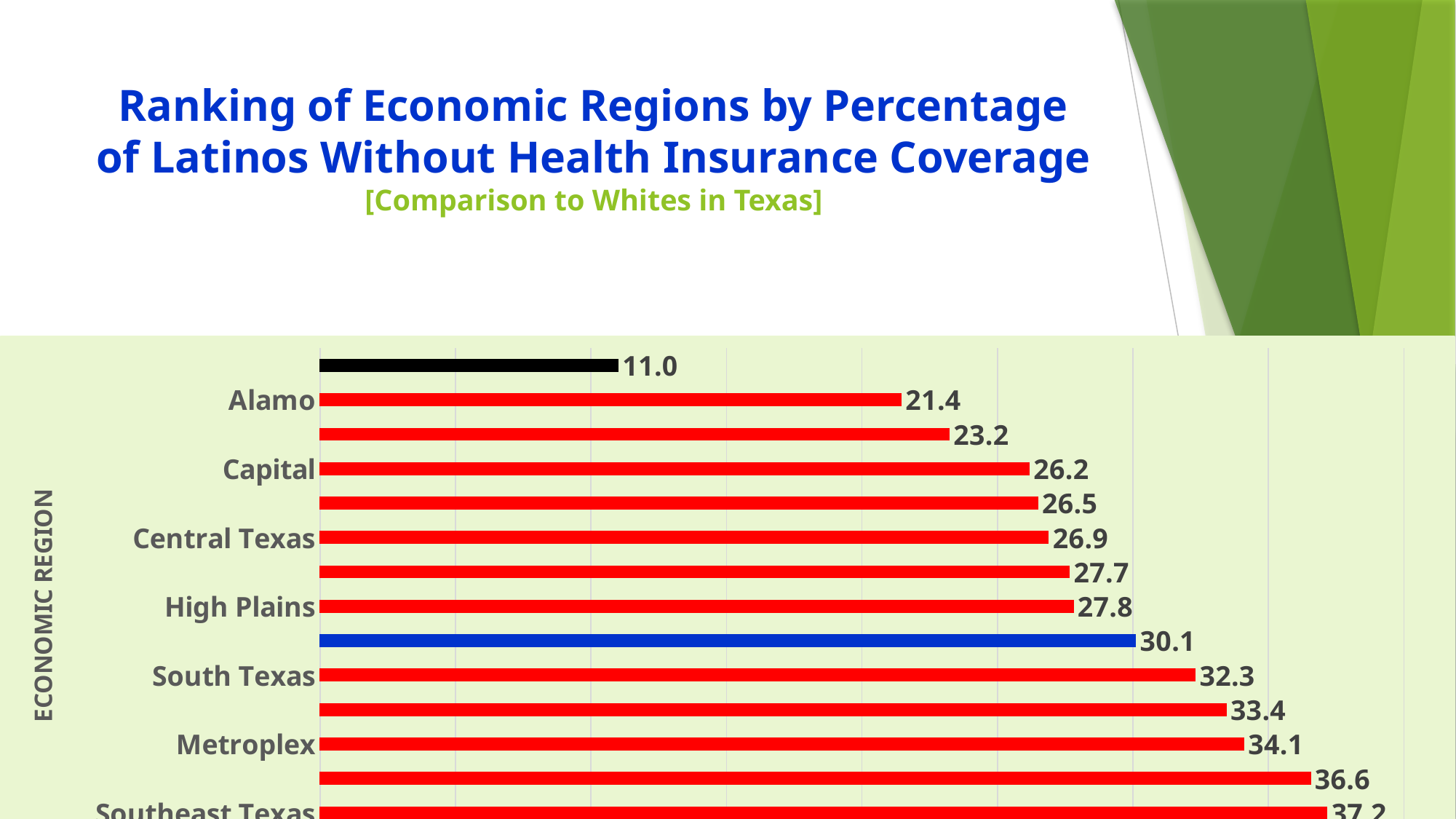
What is the value for Capital? 26.2 What is the value for Central Texas? 26.9 What is the value for South Texas? 32.3 What is the difference between the values for Central Texas and Capital? 0.7 What is the value for Metroplex? 34.1 Which has the larger value, Alamo or Capital? Capital What is the value for Alamo? 21.4 What is the value for High Plains? 27.8 What kind of chart is shown on the slide? bar chart What is the title of the vertical axis of the chart? ECONOMIC REGION What is the difference between the values for Metroplex and Alamo? 12.7 Which has the larger value, South Texas or High Plains? South Texas